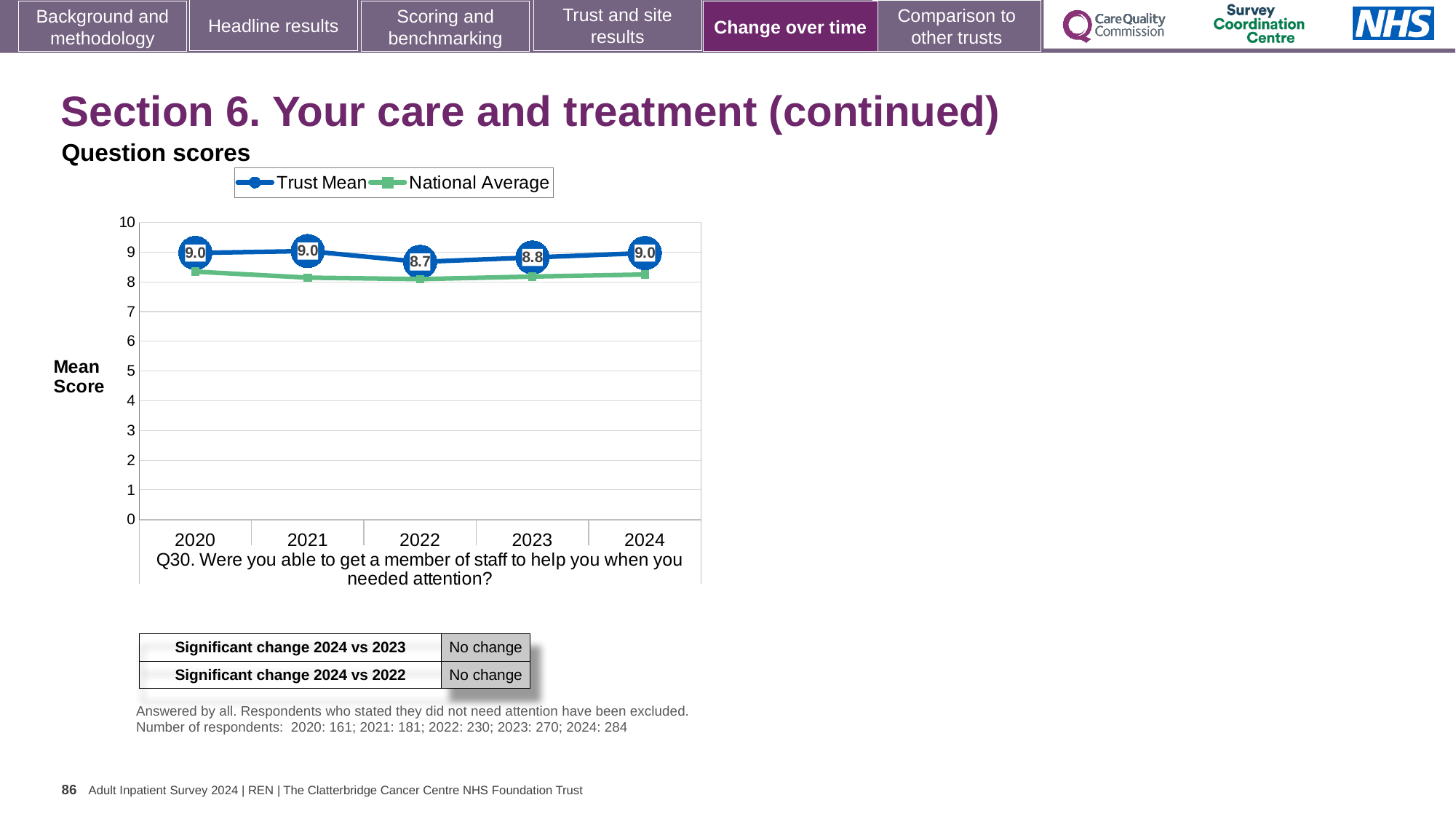
What is the Trust Mean score for 2024? 9.0 What is the Trust Mean score for 2023? 8.8 What is the difference between the Trust Mean in 2024 and in 2022? 0.3 How many series does the legend list? 2 How many years are shown on the x axis? 5 Which series is shown in green in the legend? National Average What is the Trust Mean score for 2022? 8.7 Which is larger, the Trust Mean in 2021 or the Trust Mean in 2023? 2021 What kind of chart is shown? line chart In which year is the Trust Mean lowest? 2022 Is the National Average value for 2022 greater or less than 9? less Is the National Average value for 2020 greater or less than 8? greater